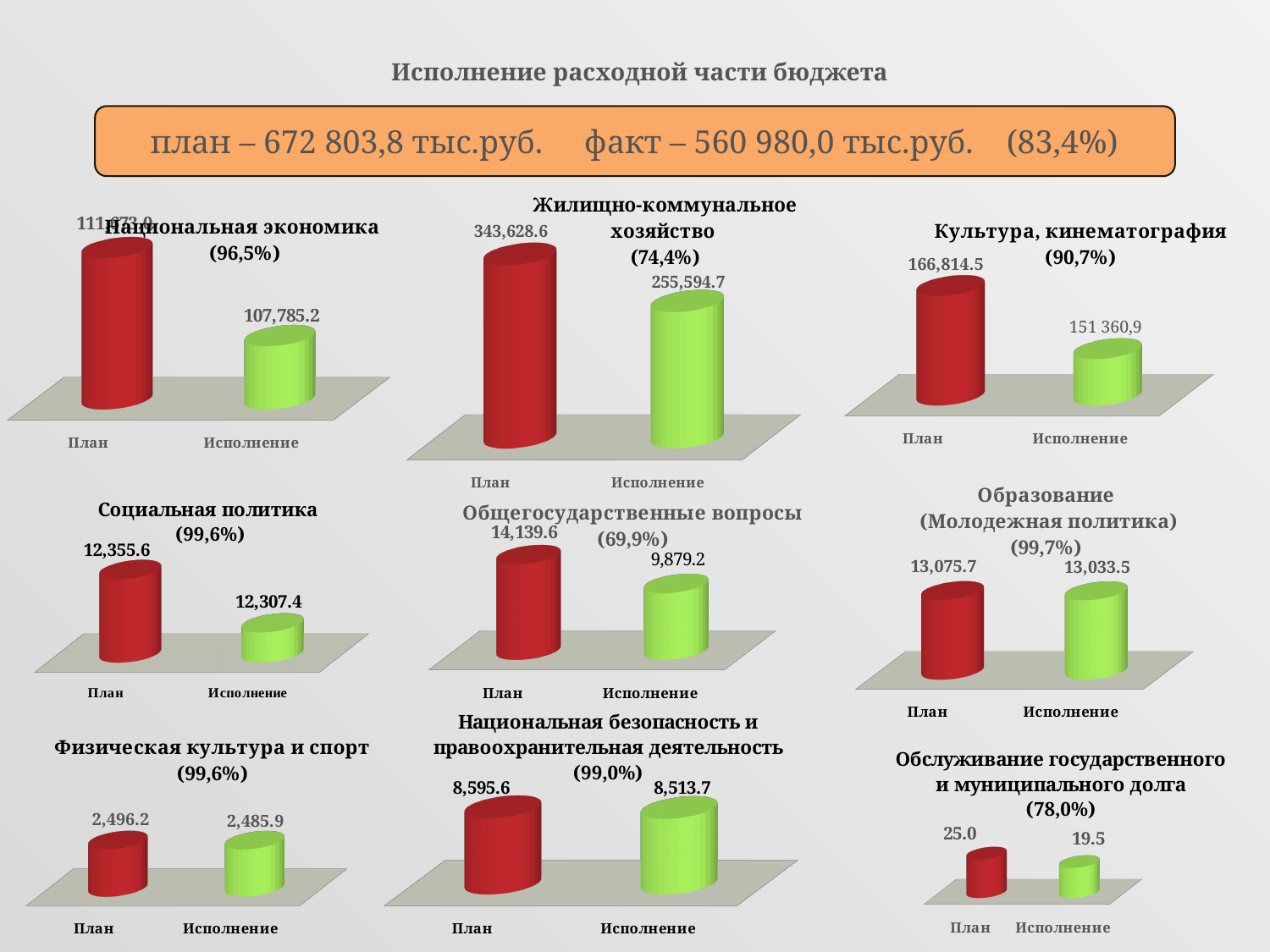
In the 'Общегосударственные вопросы' chart, what is the difference between План and Исполнение? 4,260.4 In the 'Обслуживание государственного и муниципального долга' chart, what is the difference between План and Исполнение? 5.5 In the 'Физическая культура и спорт' chart, what is the value for Исполнение? 2,485.9 What kind of chart is the 'Социальная политика' chart? Bar chart In the 'Образование (Молодежная политика)' chart, what is the value for План? 13,075.7 In the 'Жилищно-коммунальное хозяйство' chart, what is the value for План? 343,628.6 How many bars does the 'Культура, кинематография' chart show? 2 In the 'Культура, кинематография' chart, what is the value for Исполнение? 151 360,9 In the 'Национальная экономика' chart, what is the value for Исполнение? 107,785.2 In the 'Национальная безопасность и правоохранительная деятельность' chart, what is the value for План? 8,595.6 In the 'Жилищно-коммунальное хозяйство' chart, what is the value for Исполнение? 255,594.7 In the 'Социальная политика' chart, which is larger, План or Исполнение? План